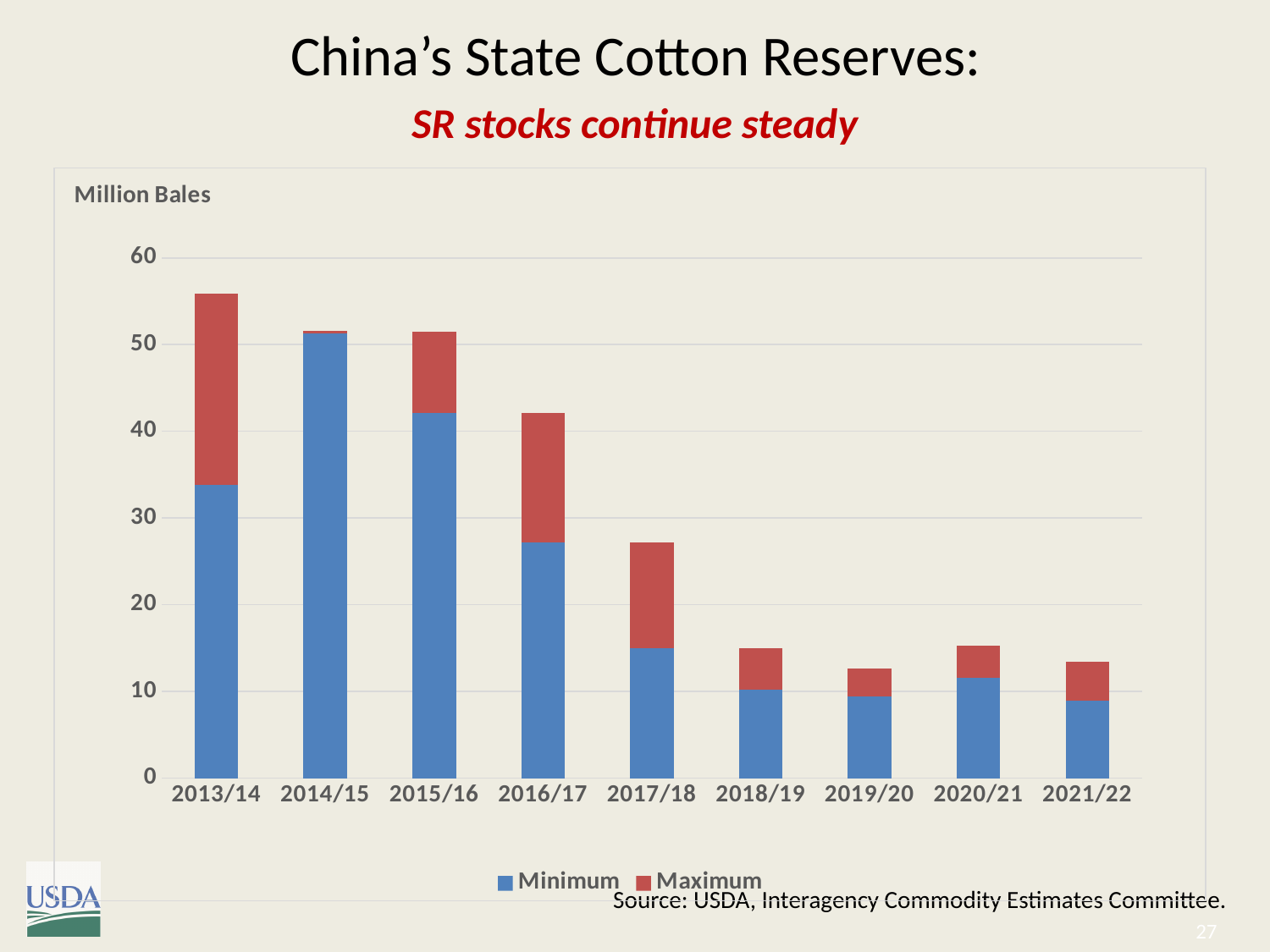
What unit is given for the y axis? Million Bales Is the Minimum value for 2017/18 greater or less than 20? less Is the total bar for 2018/19 greater or less than 20? less What kind of chart is shown on the slide? Stacked bar chart Which year has the tallest total bar? 2013/14 Which year has the largest Minimum (blue) segment? 2014/15 Is the Minimum value for 2016/17 greater or less than 20? greater Which total bar is taller, 2016/17 or 2017/18? 2016/17 Do the total bars generally rise or fall from 2013/14 to 2021/22? Fall How many series does the legend list? 2 How many marketing years are shown on the x axis? 9